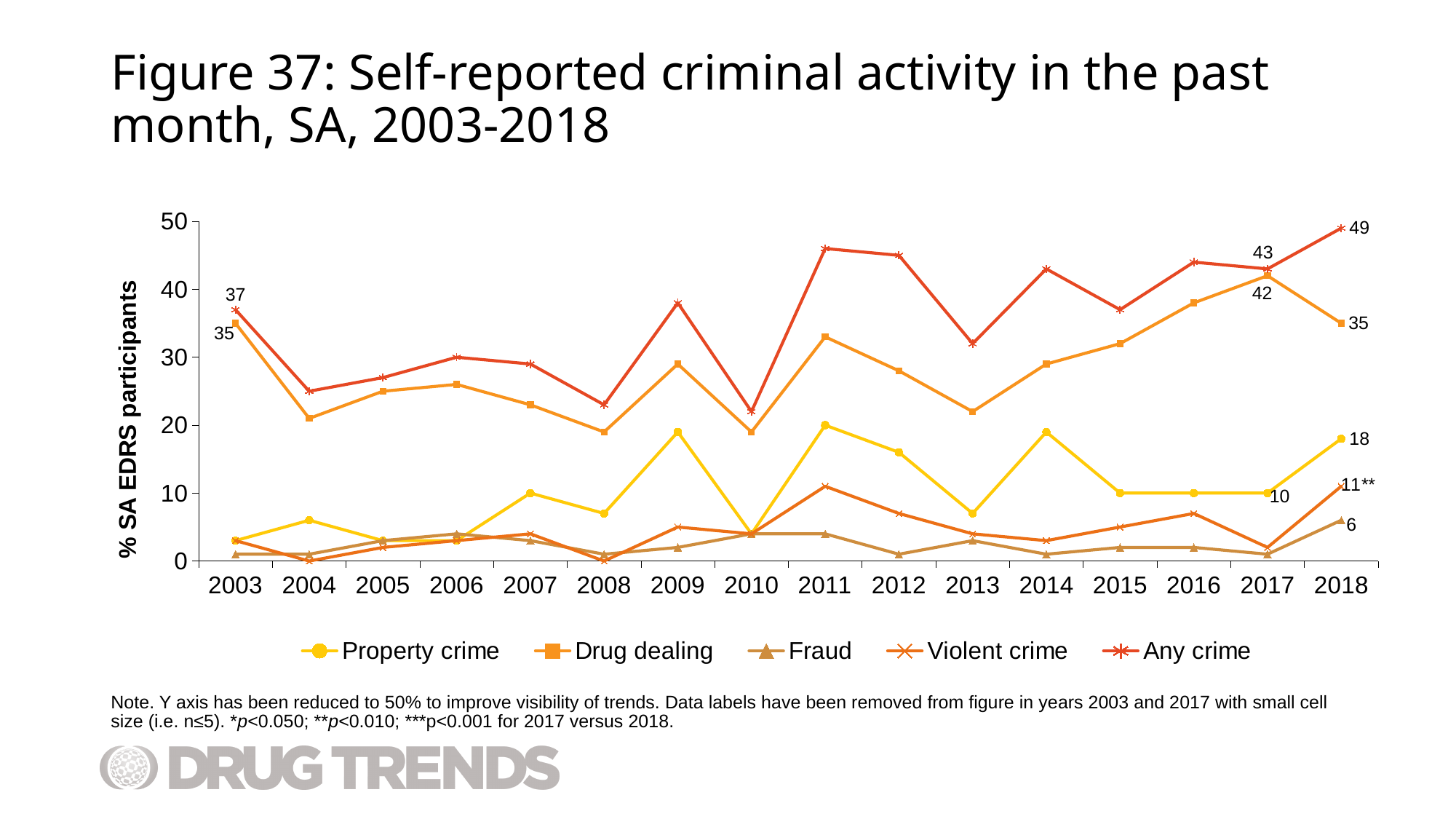
What is the value for Drug dealing in 2003? 35 What is the value for Any crime in 2018? 49 By how much did the Any crime value increase from 2017 to 2018? 6 What is the value for Drug dealing in 2018? 35 Is the value for Any crime in 2011 greater or less than 40? greater What is the value for Property crime in 2017? 10 What is the value for Fraud in 2018? 6 In 2003, which is larger: Any crime or Drug dealing? Any crime What is the difference between the Drug dealing values in 2017 and 2018? 7 How many series does the legend list? 5 What kind of chart is shown on the slide? line chart Which series has the highest value in 2018? Any crime